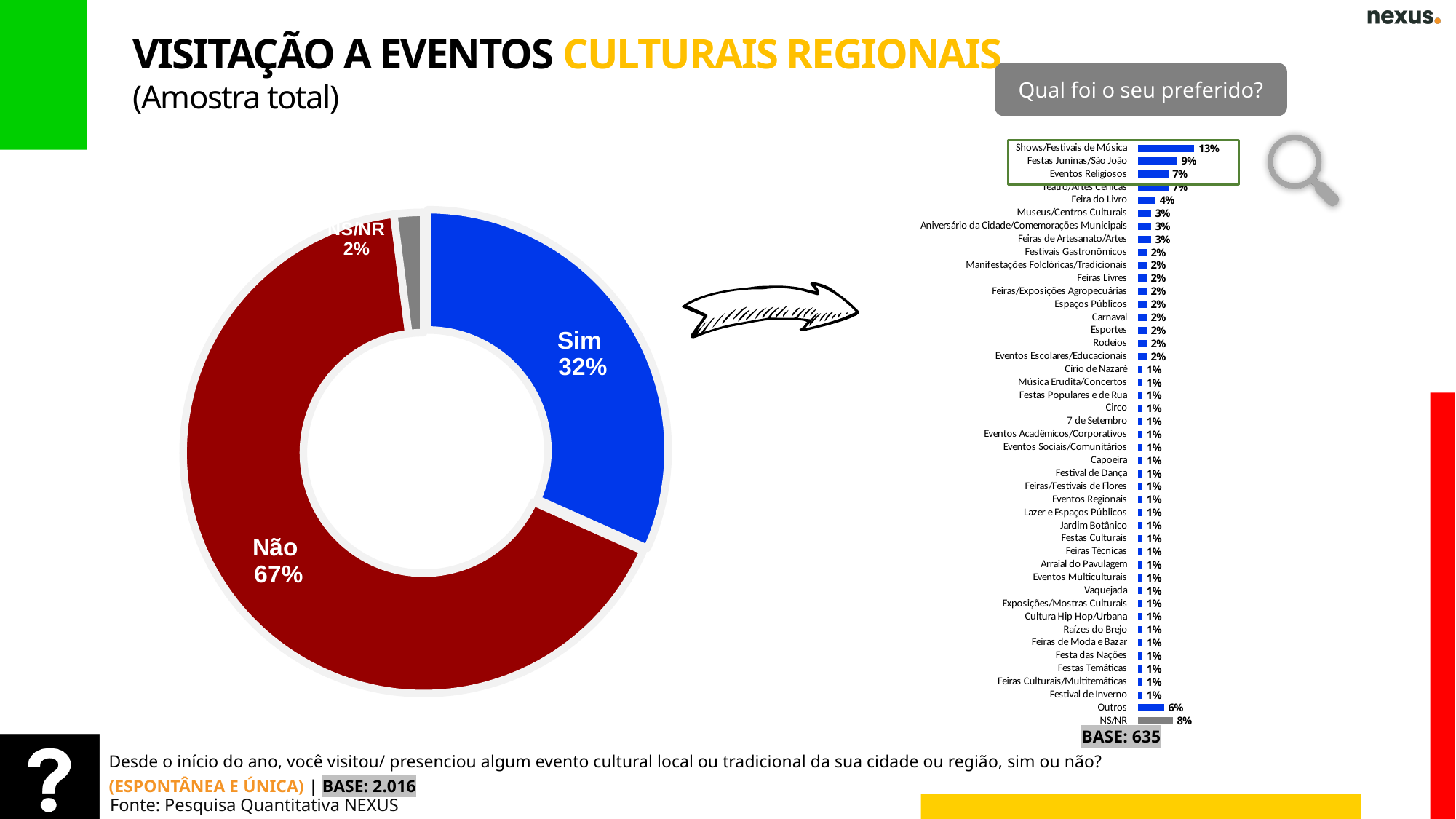
In the bar chart "Qual foi o seu preferido?", which category has the highest value? Shows/Festivais de Música In the bar chart "Qual foi o seu preferido?", what is the value for Shows/Festivais de Música? 13% In the bar chart "Qual foi o seu preferido?", what is the value for Festas Juninas/São João? 9% How many categories does the donut chart on the left show? 3 In the donut chart on the left, what percentage answered "Sim"? 32% In the donut chart on the left, which category has the largest share? Não In the bar chart "Qual foi o seu preferido?", which is larger: Feira do Livro or Museus/Centros Culturais? Feira do Livro In the donut chart on the left, what percentage answered "Não"? 67% In the donut chart on the left, what is the value for NS/NR? 2% In the bar chart "Qual foi o seu preferido?", what is the difference between Shows/Festivais de Música and Festas Juninas/São João? 4% In the donut chart on the left, what is the difference between the "Não" and "Sim" shares? 35% What kind of chart is the one on the right of the slide, titled "Qual foi o seu preferido?"? Bar chart